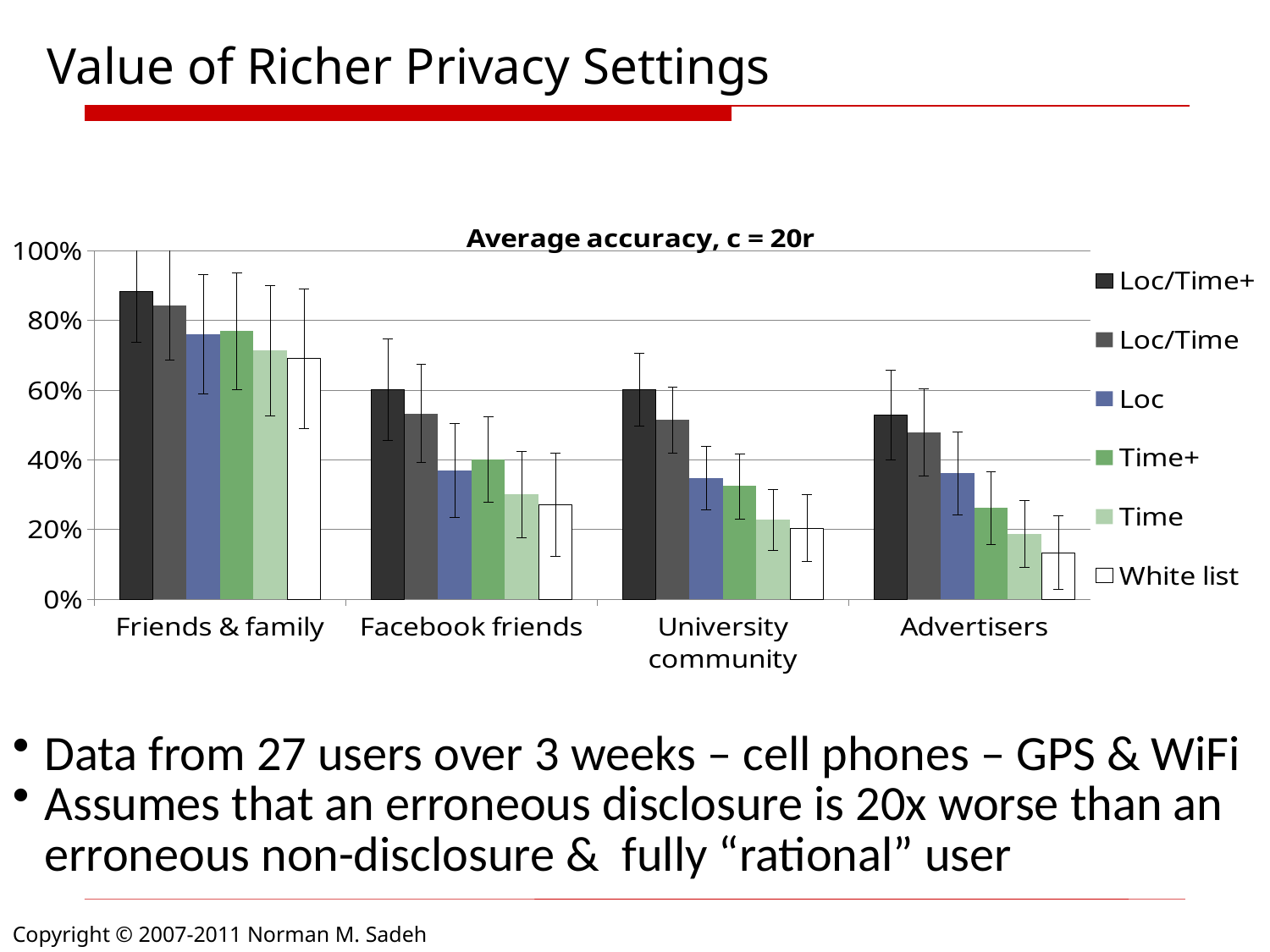
Which is larger: the Loc/Time+ value for Facebook friends or for Advertisers? Facebook friends How many series does the legend list? 6 Is the Loc/Time+ value for Friends & family greater or less than 80%? greater What kind of chart is shown on the slide? bar chart Is the White list value for Advertisers greater or less than 20%? less Which category has the highest Loc/Time+ value? Friends & family Is the Time value for University community greater or less than 40%? less How many categories are shown on the x axis? 4 Which category has the lowest White list value? Advertisers What is the title of the chart? Average accuracy, c = 20r For Advertisers, which is larger: the Loc/Time+ value or the White list value? Loc/Time+ Do the White list values rise or fall moving from Friends & family to Advertisers along the x axis? fall